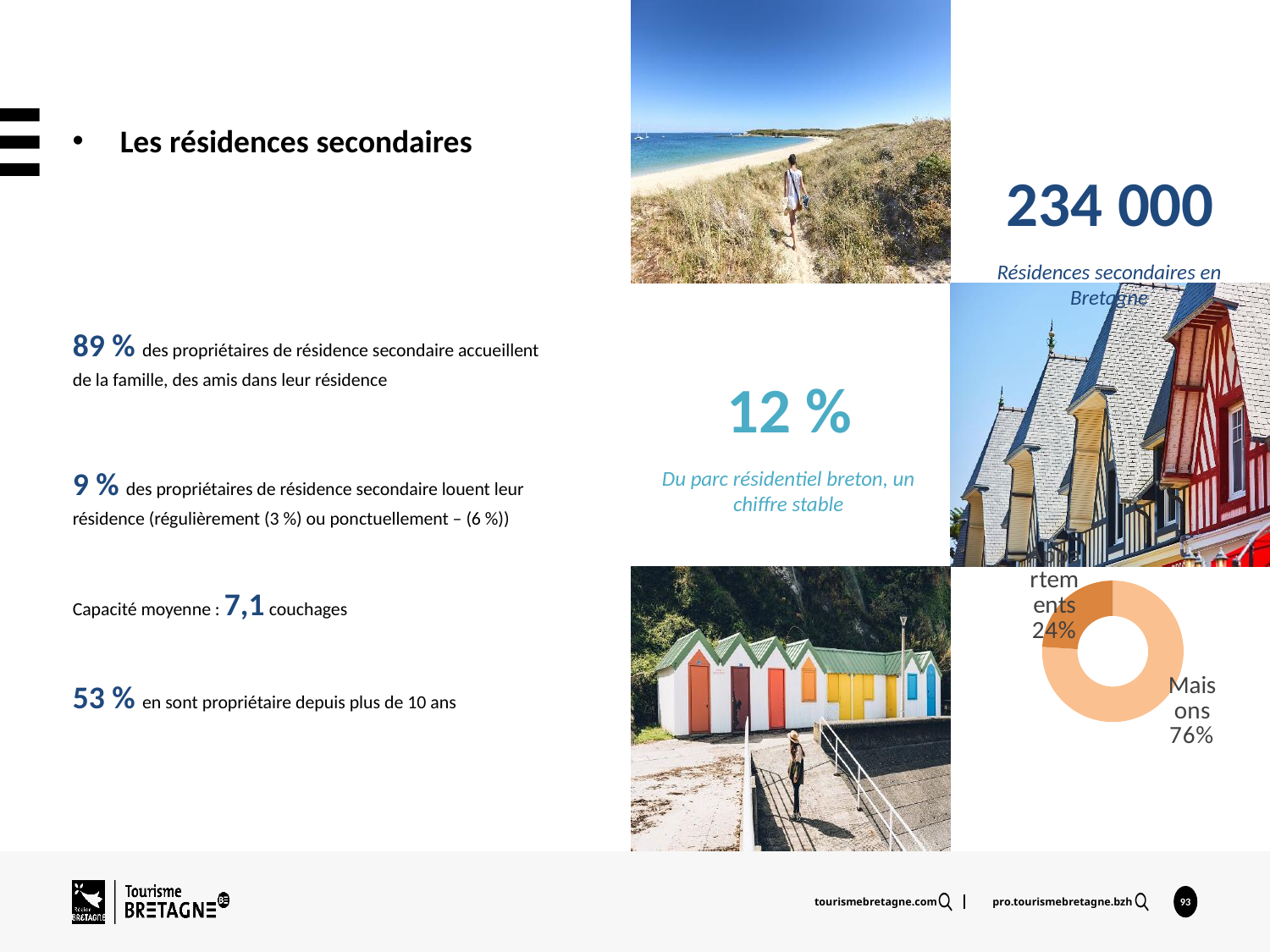
In the donut chart at the bottom right, is the Maisons slice larger or smaller than the other slice? Larger In the donut chart at the bottom right, what share is shown for Maisons? 76% In the donut chart at the bottom right, what percentage is shown for the smaller slice? 24% In the donut chart at the bottom right, which slice is the largest? Maisons In the donut chart at the bottom right, what is the share of the smallest slice? 24% In the donut chart at the bottom right, what is the difference in percentage points between the Maisons slice and the smaller slice? 52 percentage points In the donut chart at the bottom right, how many slices are there? 2 In the donut chart at the bottom right, what share of the whole does Maisons represent? 76% In the donut chart at the bottom right, what do the two slices add up to? 100% In the donut chart at the bottom right, what colour is the Maisons slice? Light orange What kind of chart is shown at the bottom right of the slide? Pie chart (donut)